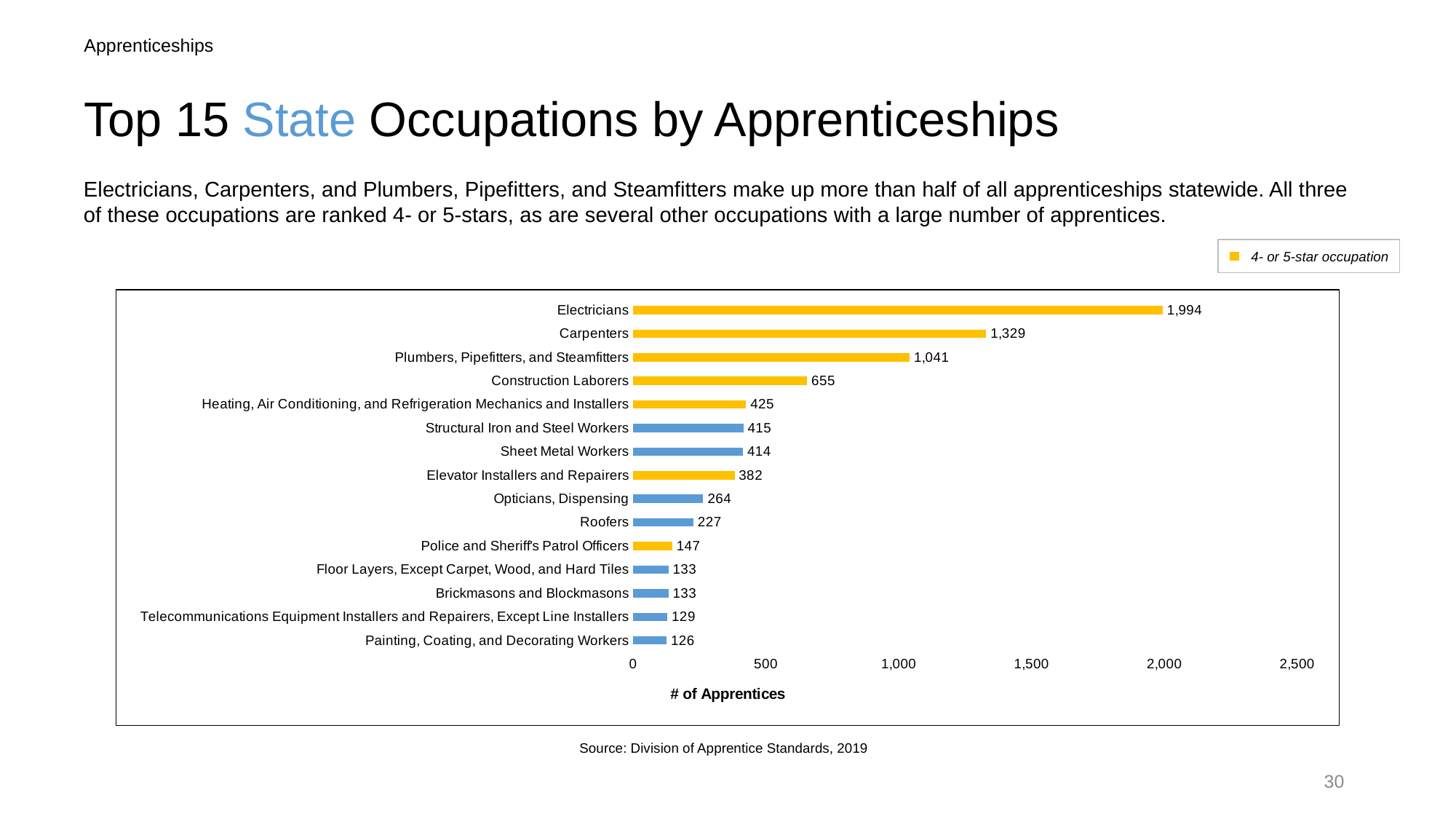
How many apprentices are shown for Roofers? 227 What kind of chart is shown on the slide? Bar chart What is the label of the horizontal axis? # of Apprentices How many apprentices are shown for Sheet Metal Workers? 414 What is the difference in apprentices between Electricians and Carpenters? 665 What does the yellow bar colour indicate according to the legend? 4- or 5-star occupation How many occupations are shown on the chart? 15 What is the difference in apprentices between Construction Laborers and Elevator Installers and Repairers? 273 Which occupation has the highest number of apprentices? Electricians Which occupation has the lowest number of apprentices on the chart? Painting, Coating, and Decorating Workers How many apprentices are shown for Electricians? 1,994 Which has more apprentices, Opticians, Dispensing or Roofers? Opticians, Dispensing